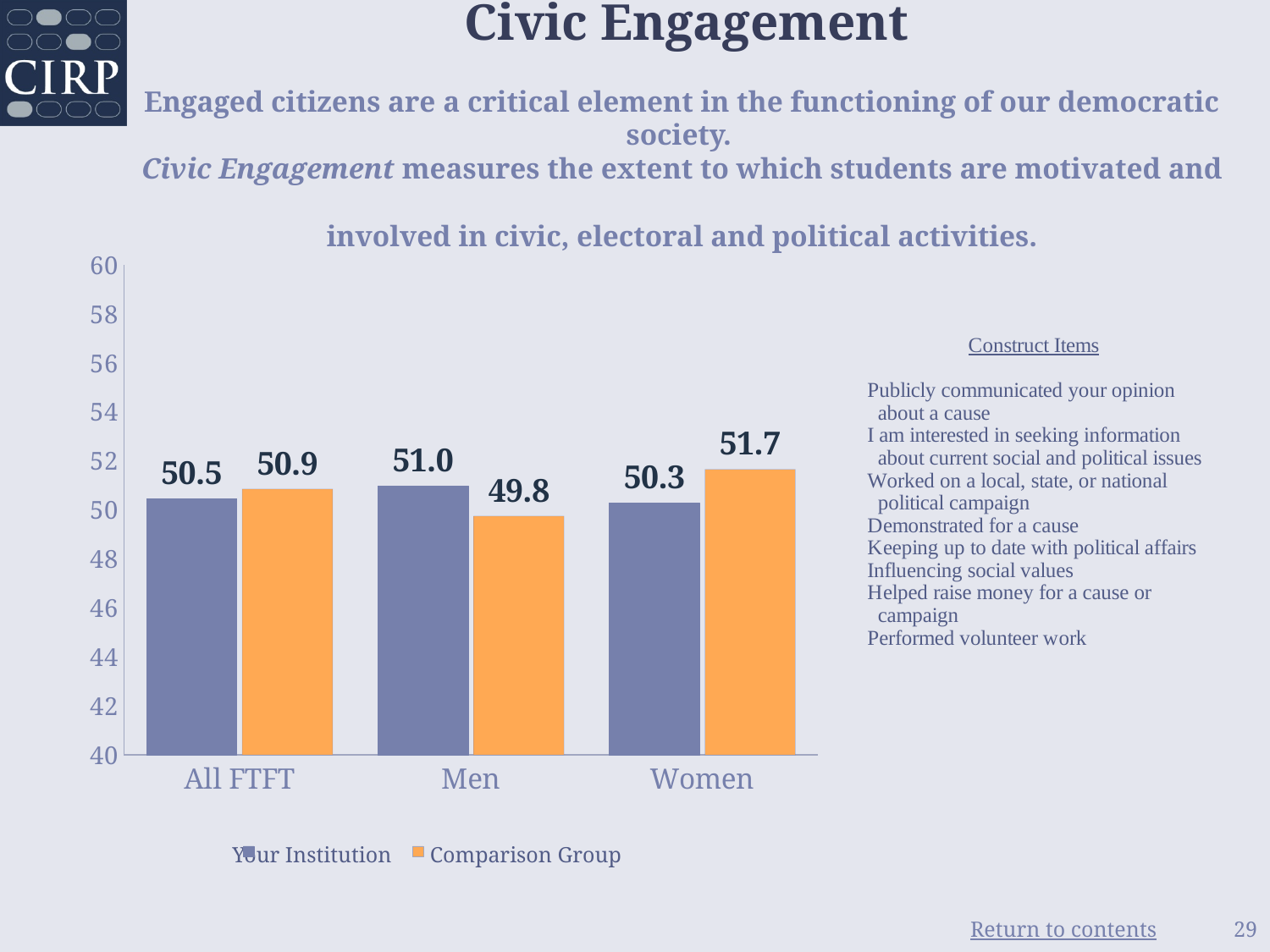
What is the Comparison Group value for Men? 49.8 How many categories are shown on the x axis? 3 What is the difference between the Your Institution and Comparison Group values for Men? 1.2 What kind of chart is shown on the slide? Bar chart What is the difference between the Comparison Group and Your Institution values for Women? 1.4 What is the Comparison Group value for Women? 51.7 Which category has the highest Comparison Group value? Women How many series does the legend list? 2 What is the Your Institution value for All FTFT? 50.5 Which category has the lowest Comparison Group value? Men For Men, which is larger: Your Institution or Comparison Group? Your Institution What is the Your Institution value for Women? 50.3